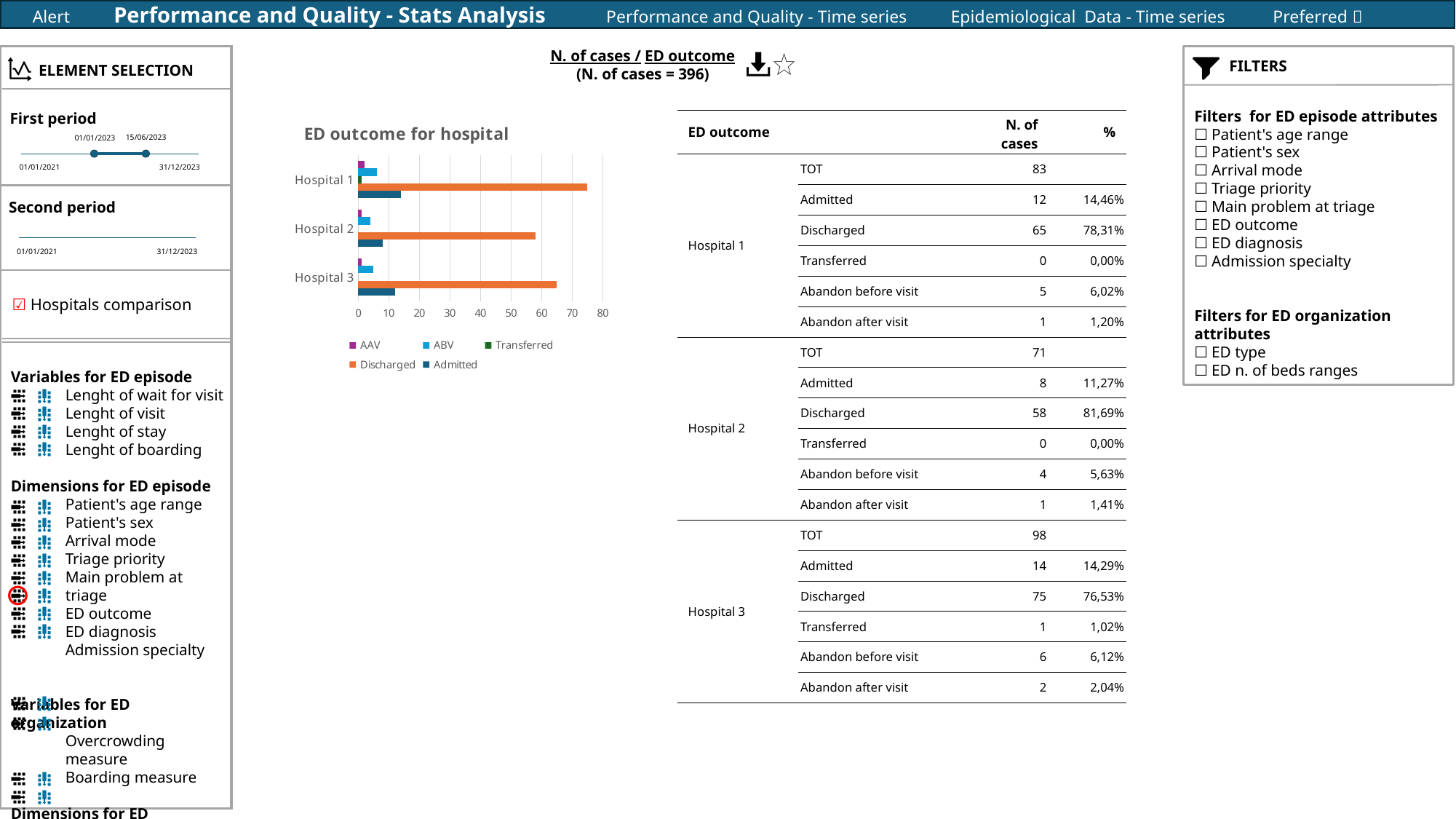
How many series does the legend of the 'ED outcome for hospital' chart list? 5 What is the title of the bar chart on the slide? ED outcome for hospital In the 'ED outcome for hospital' chart, which colour represents the Discharged series? orange What type of chart is 'ED outcome for hospital'? bar chart How many hospitals are shown on the 'ED outcome for hospital' chart? 3 In the 'ED outcome for hospital' chart, which is larger for Hospital 2: Discharged or Admitted? Discharged In the 'ED outcome for hospital' chart, is the Discharged value for Hospital 2 greater or less than 60? less In the 'ED outcome for hospital' chart, is the Discharged value for Hospital 1 greater or less than 70? greater In the 'ED outcome for hospital' chart, which hospital has the shortest Discharged bar? Hospital 2 In the 'ED outcome for hospital' chart, is the Discharged value for Hospital 3 greater or less than 60? greater In the 'ED outcome for hospital' chart, which hospital has the longest Discharged bar? Hospital 1